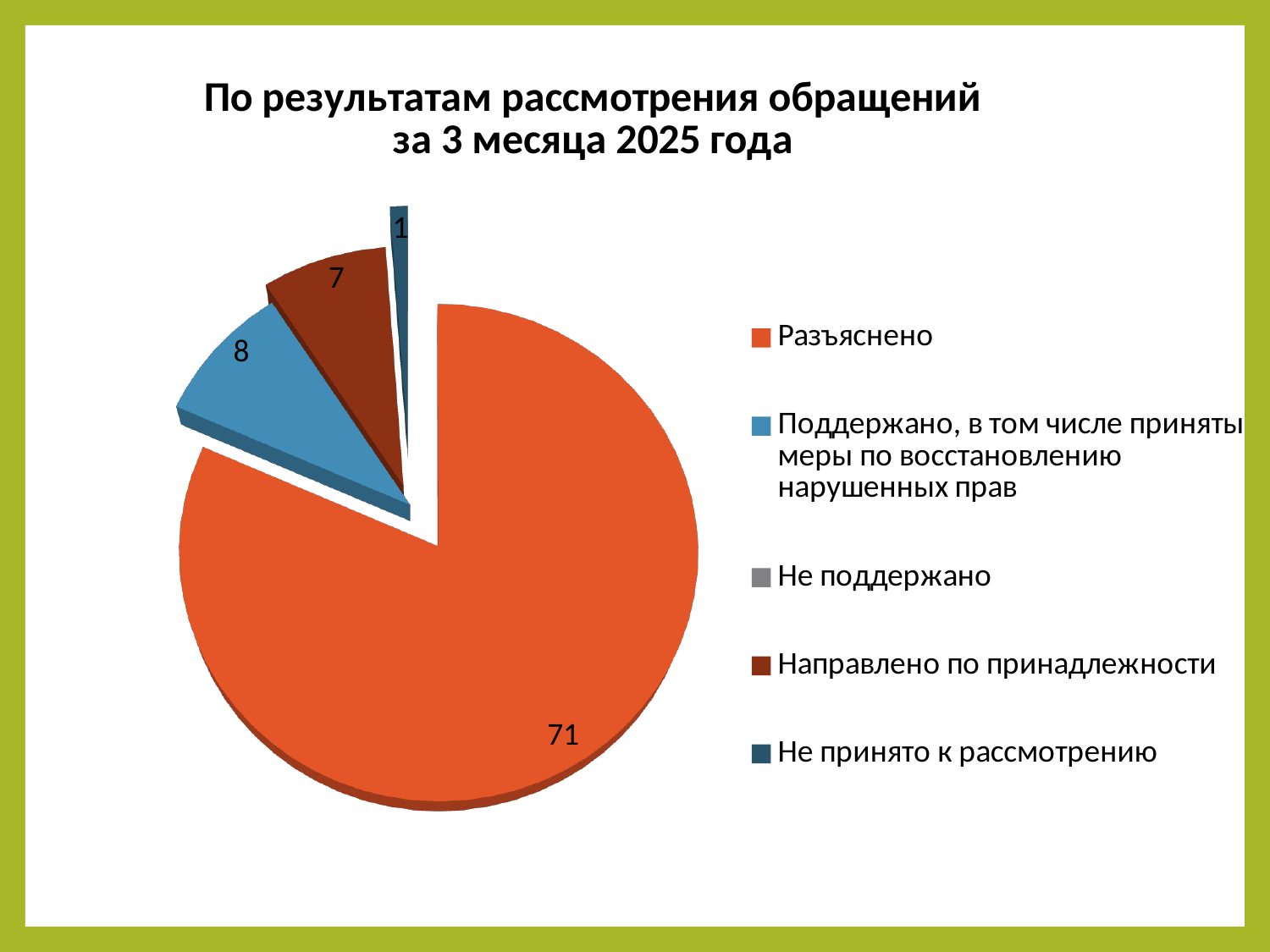
What is the difference between the Разъяснено value and the Поддержано value? 63 What value is shown for the Направлено по принадлежности slice? 7 What value is shown for the Разъяснено slice? 71 How many categories does the legend list? 5 What is the difference between the Поддержано value and the Направлено по принадлежности value? 1 Which labelled slice has the smallest value? Не принято к рассмотрению What value is shown for the Не принято к рассмотрению slice? 1 What value is shown for the Поддержано, в том числе приняты меры по восстановлению нарушенных прав slice? 8 Which is larger: the value for Направлено по принадлежности or the value for Не принято к рассмотрению? Направлено по принадлежности What is the title of the chart? По результатам рассмотрения обращений за 3 месяца 2025 года What kind of chart is shown on the slide? Pie chart Which category has the largest slice of the pie? Разъяснено